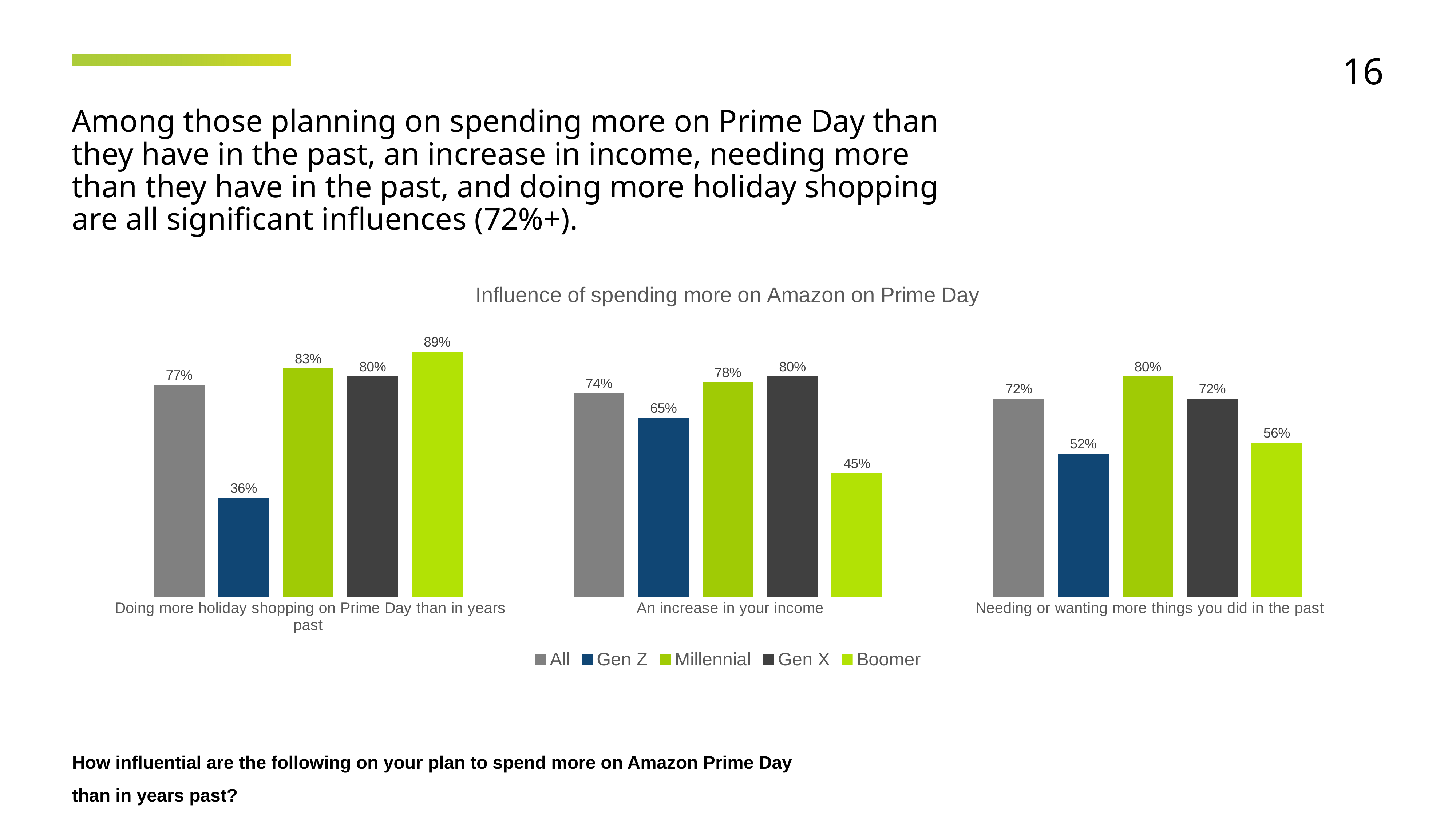
How many series does the legend list? 5 What is the value for Gen Z for 'Doing more holiday shopping on Prime Day than in years past'? 36% Which is larger for 'Needing or wanting more things you did in the past': Gen Z or Boomer? Boomer Which series has the lowest value for 'An increase in your income'? Boomer What kind of chart is shown on the slide? Bar chart What is the value for All for 'An increase in your income'? 74% What is the value for Boomer for 'An increase in your income'? 45% What is the title of the chart? Influence of spending more on Amazon on Prime Day How many categories are shown on the x axis? 3 Which series has the highest value for 'Doing more holiday shopping on Prime Day than in years past'? Boomer What is the difference between the Boomer and Gen Z values for 'Doing more holiday shopping on Prime Day than in years past'? 53% What is the value for Millennial for 'Needing or wanting more things you did in the past'? 80%